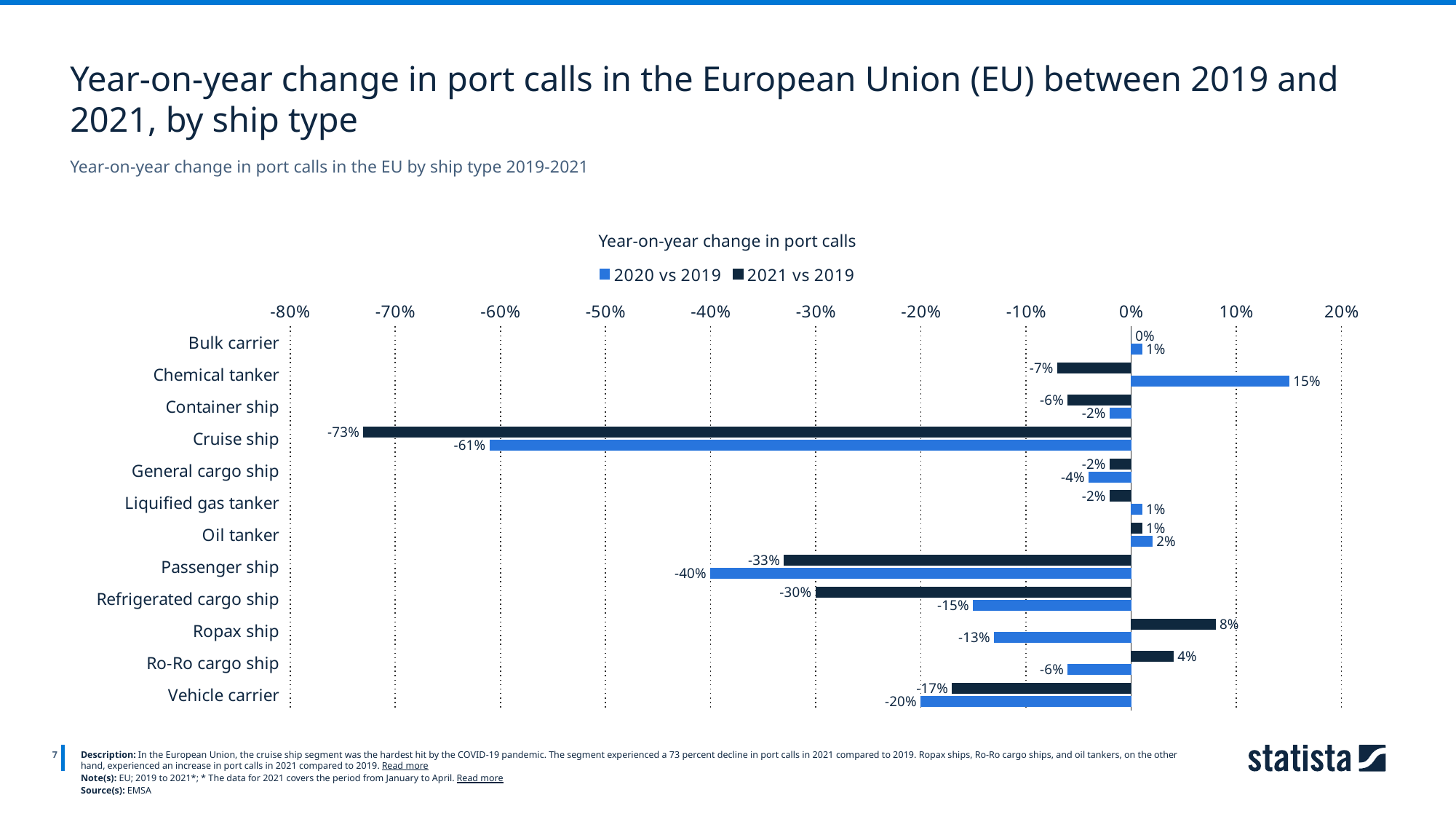
How many ship types are shown in the chart? 12 What type of chart is shown on the slide? Bar chart Which ship type has the highest 2020 vs 2019 change in port calls? Chemical tanker What is the 2021 vs 2019 change in port calls for Ropax ships? 8% Which ship type has the lowest 2021 vs 2019 change in port calls? Cruise ship What is the 2021 vs 2019 change in port calls for cruise ships? -73% Which colour represents the 2021 vs 2019 series? Dark navy How many series does the legend list? 2 What is the 2020 vs 2019 change in port calls for passenger ships? -40% What is the 2020 vs 2019 change in port calls for chemical tankers? 15% Which is larger for vehicle carriers: the 2020 vs 2019 change or the 2021 vs 2019 change? 2021 vs 2019 What is the difference between the 2020 vs 2019 and 2021 vs 2019 changes for refrigerated cargo ships? 15 percentage points